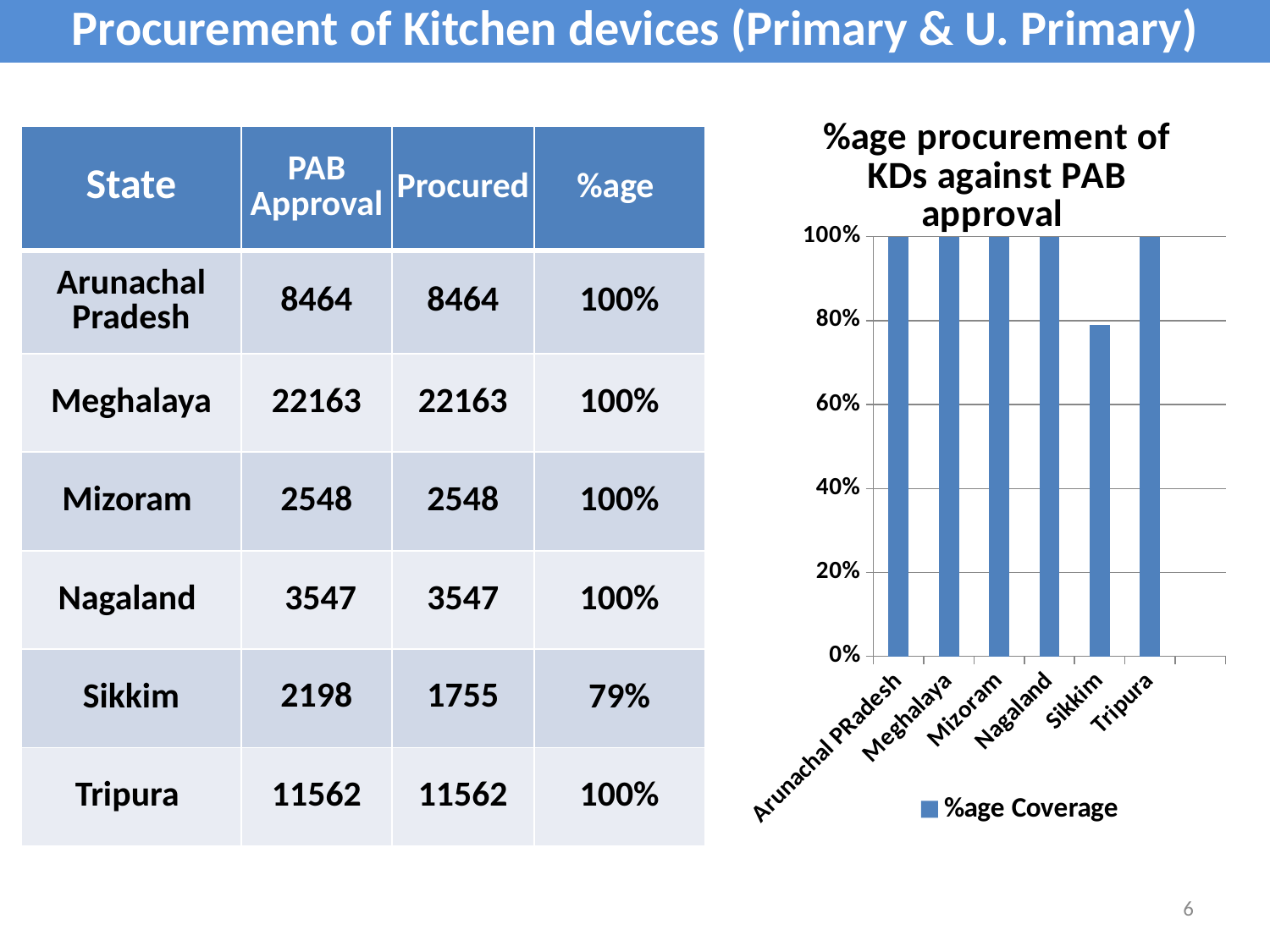
Which state has the lowest %age coverage in the chart? Sikkim How many series does the chart legend list? 1 What is the difference between the %age coverage for Mizoram and Sikkim? 21% Which is larger in the chart, the value for Nagaland or the value for Sikkim? Nagaland What is the %age coverage for Meghalaya in the chart? 100% What is the %age coverage for Tripura in the chart? 100% How many states are plotted on the chart? 6 Is the value for Sikkim in the chart greater or less than 60%? greater What is the title of the chart? %age procurement of KDs against PAB approval What is the name of the series shown in the chart legend? %age Coverage What is the %age coverage for Sikkim in the chart? 79% What kind of chart is shown on the slide? bar chart